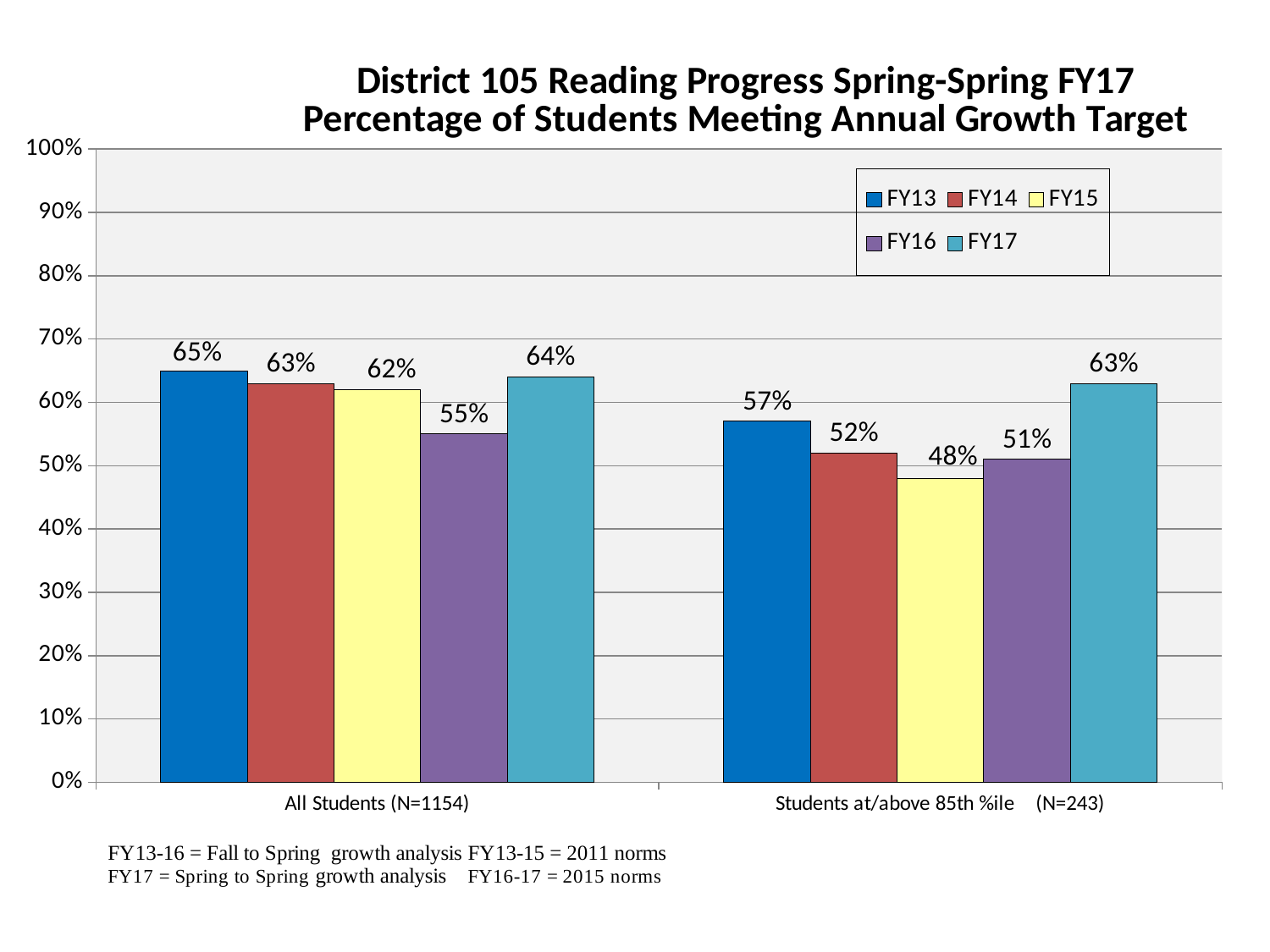
How many student groups are shown on the x axis? 2 What colour represents FY15 in the chart? yellow Is the FY16 value for Students at/above 85th %ile greater or less than 60%? less What percentage of All Students (N=1154) met the annual growth target in FY13? 65% Which fiscal year has the lowest value for All Students (N=1154)? FY16 What is the FY15 value for Students at/above 85th %ile (N=243)? 48% How many series does the legend list? 5 What kind of chart is shown on the slide? bar chart Which fiscal year has the highest value for Students at/above 85th %ile (N=243)? FY17 What is the FY17 value for All Students (N=1154)? 64% What is the difference between the FY13 values for All Students and Students at/above 85th %ile? 8% Which is larger for Students at/above 85th %ile: the FY14 value or the FY16 value? FY14